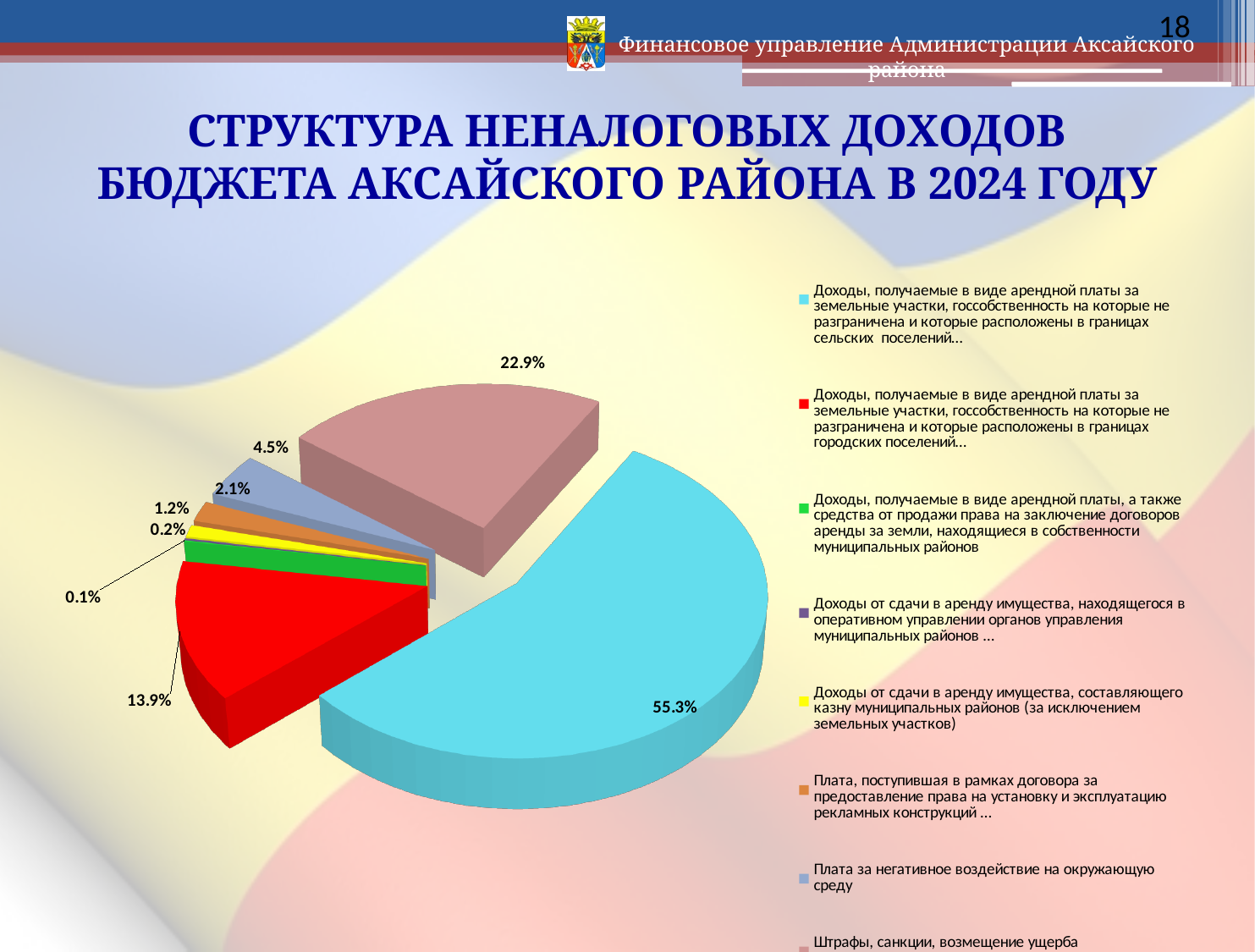
What kind of chart is shown on the slide? Pie chart What is the largest percentage shown on the pie chart? 55.3% What is the smallest percentage labelled on the pie chart? 0.1% What share of non-tax revenue comes from rent for land plots in urban settlements (... в границах городских поселений)? 13.9% Which is larger: the share for rent of land in urban settlements or the share for 'Штрафы, санкции, возмещение ущерба'? Штрафы, санкции, возмещение ущерба How many categories does the legend of the pie chart list? 8 What share of non-tax revenue comes from rent for land plots in rural settlements (Доходы, получаемые в виде арендной платы за земельные участки ... в границах сельских поселений)? 55.3% What share is shown for 'Плата за негативное воздействие на окружающую среду'? 4.5% What is the difference in percentage points between the largest slice (55.3%) and the 'Штрафы, санкции, возмещение ущерба' slice (22.9%)? 32.4 percentage points What is the title of the chart on the slide? СТРУКТУРА НЕНАЛОГОВЫХ ДОХОДОВ БЮДЖЕТА АКСАЙСКОГО РАЙОНА В 2024 ГОДУ What share is shown for 'Штрафы, санкции, возмещение ущерба'? 22.9%